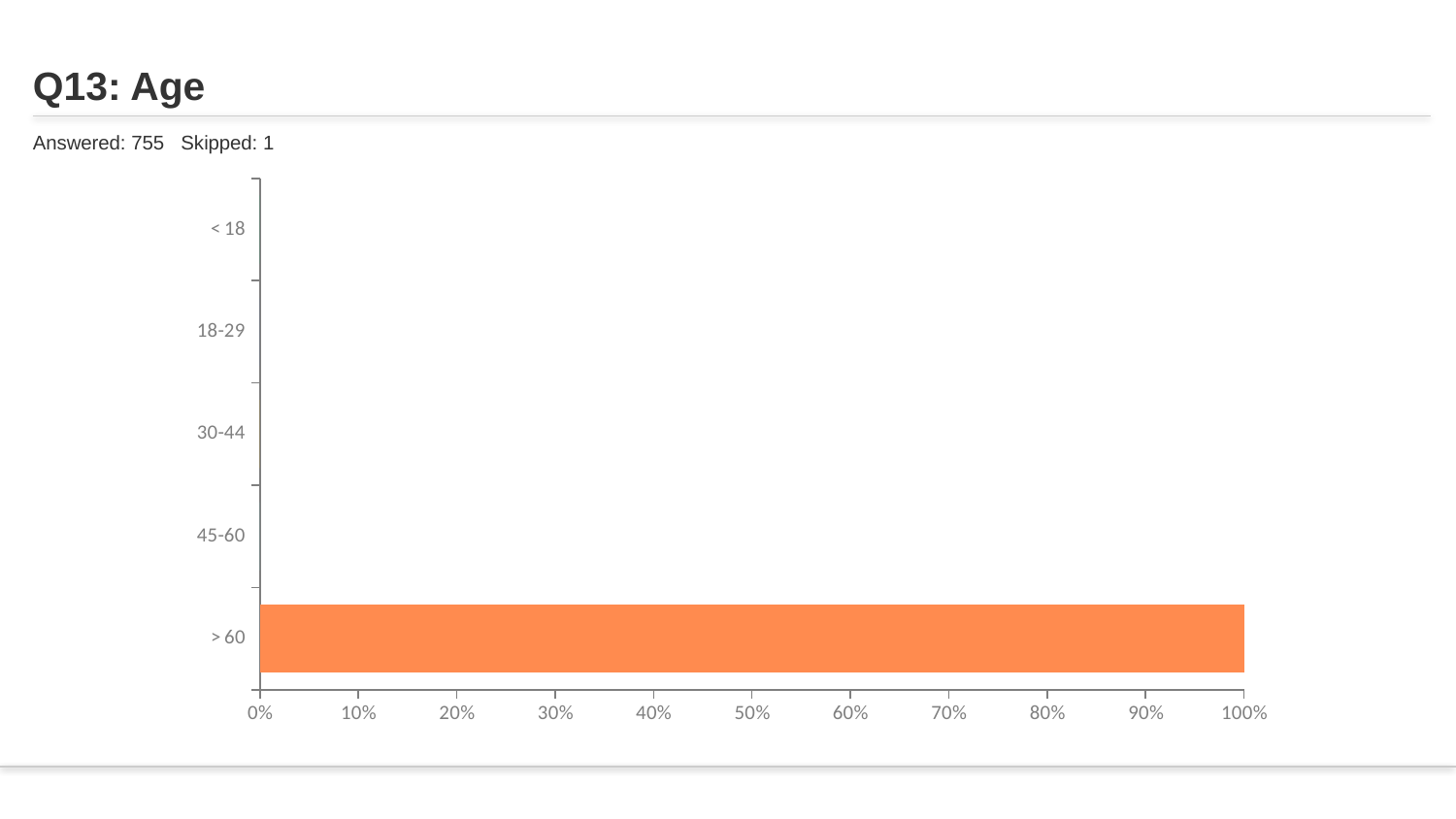
How many respondents answered this question according to the slide? 755 Which is larger, the value for > 60 or the value for 30-44? > 60 Which is larger, the value for < 18 or the value for > 60? > 60 How many age categories are shown on the chart? 5 Is the value for the 45-60 category greater or less than 10%? less Which age category has the highest value? > 60 What is the title of the chart? Q13: Age What kind of chart is shown on the slide? bar chart Is the value for the 18-29 category greater or less than 50%? less What is the value for the > 60 category? 100% Is the value for the > 60 category greater or less than 90%? greater